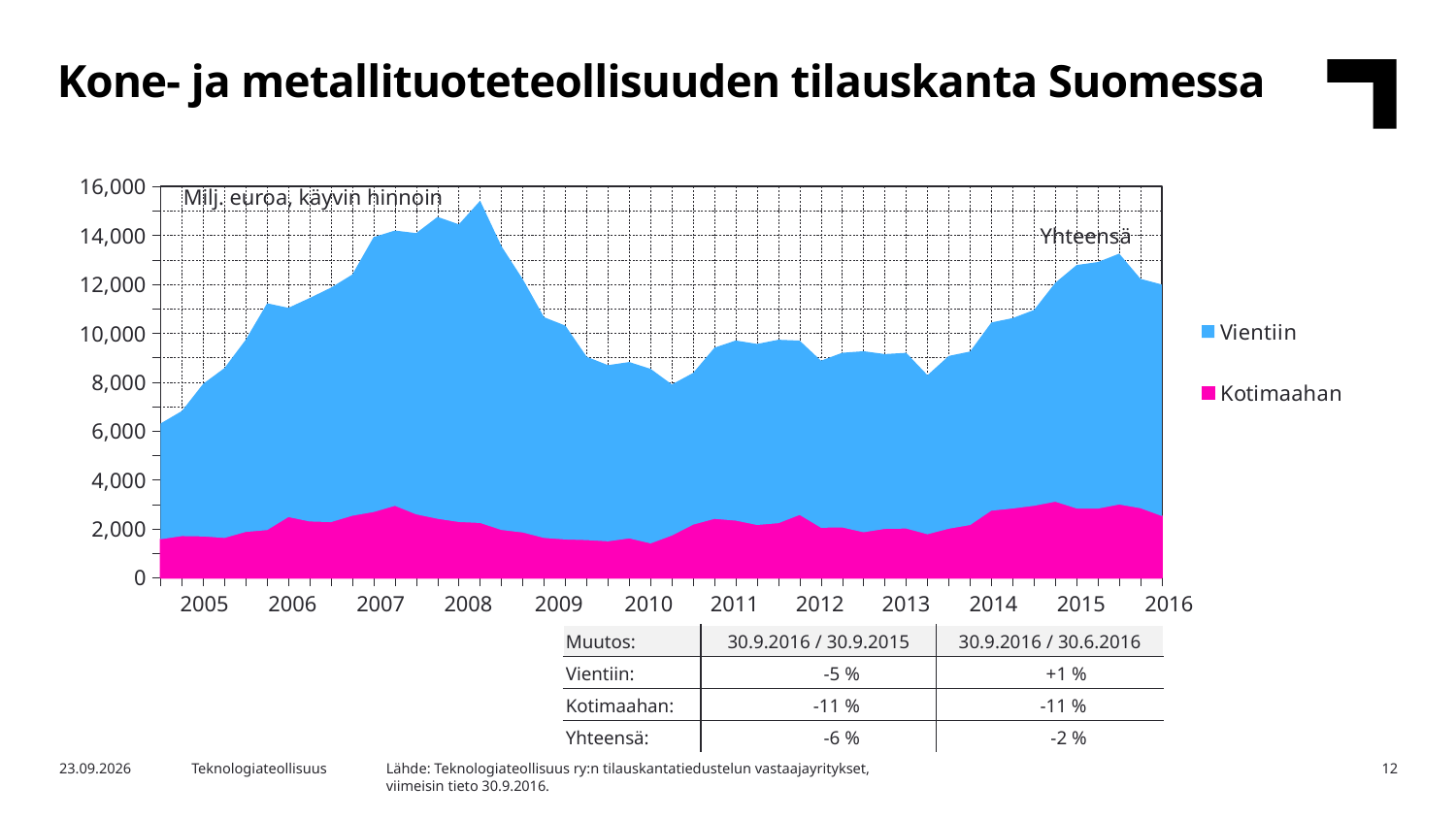
Is the peak total value in 2008 greater or less than 14,000? greater Is the Kotimaahan value in 2010 greater or less than 2,000? less In which year does the total (Yhteensä) order book reach its highest peak? 2008 Which two series are listed in the chart legend? Vientiin and Kotimaahan In which year is the total (Yhteensä) order book at its lowest? 2005 According to the table below the chart, what is the change in Vientiin for 30.9.2016 / 30.9.2015? -5 % Does the total order book rise or fall between 2008 and 2009? fall How many series does the chart legend list? 2 What unit is stated in the label at the top left of the chart area? Milj. euroa, käyvin hinnoin What kind of chart is shown on the slide? Stacked area chart How many year labels are shown on the x axis? 12 Is the total value in 2010 greater or less than 10,000? less